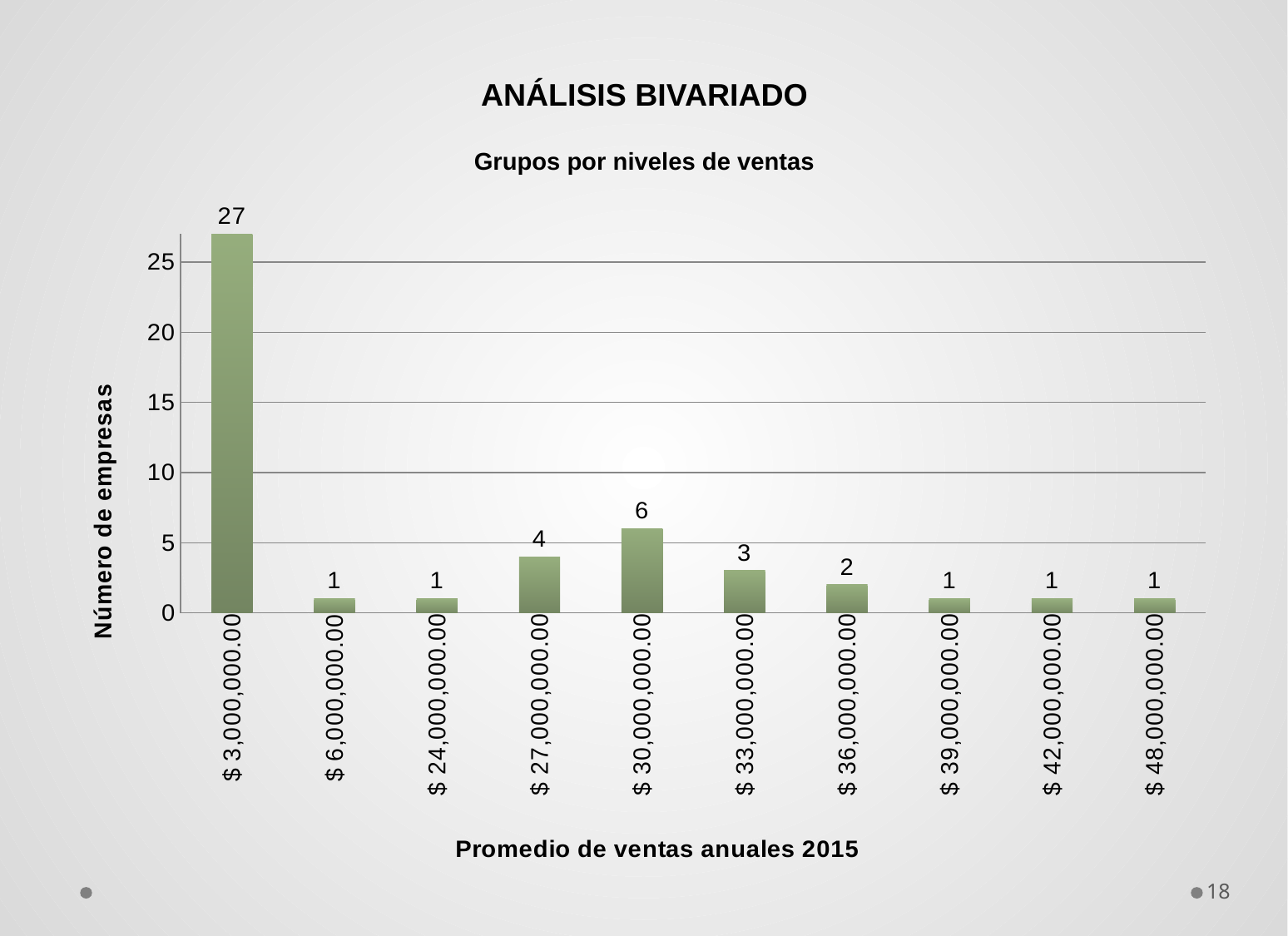
What is the difference in number of companies between the $ 3,000,000.00 group and the $ 30,000,000.00 group? 21 How many sales groups are shown on the x axis? 10 How many companies are in the $ 3,000,000.00 sales group? 27 Which has more companies, the $ 33,000,000.00 group or the $ 36,000,000.00 group? $ 33,000,000.00 What is the title of the chart? Grupos por niveles de ventas What is the difference between the $ 30,000,000.00 group and the $ 33,000,000.00 group? 3 What type of chart is shown on the slide? Bar chart What is the value shown for the $ 27,000,000.00 group? 4 Which sales group has the highest number of companies? $ 3,000,000.00 What is the number of companies for the $ 30,000,000.00 group? 6 Is the value for the $ 3,000,000.00 group greater or less than 25? greater What is the label of the y axis? Número de empresas